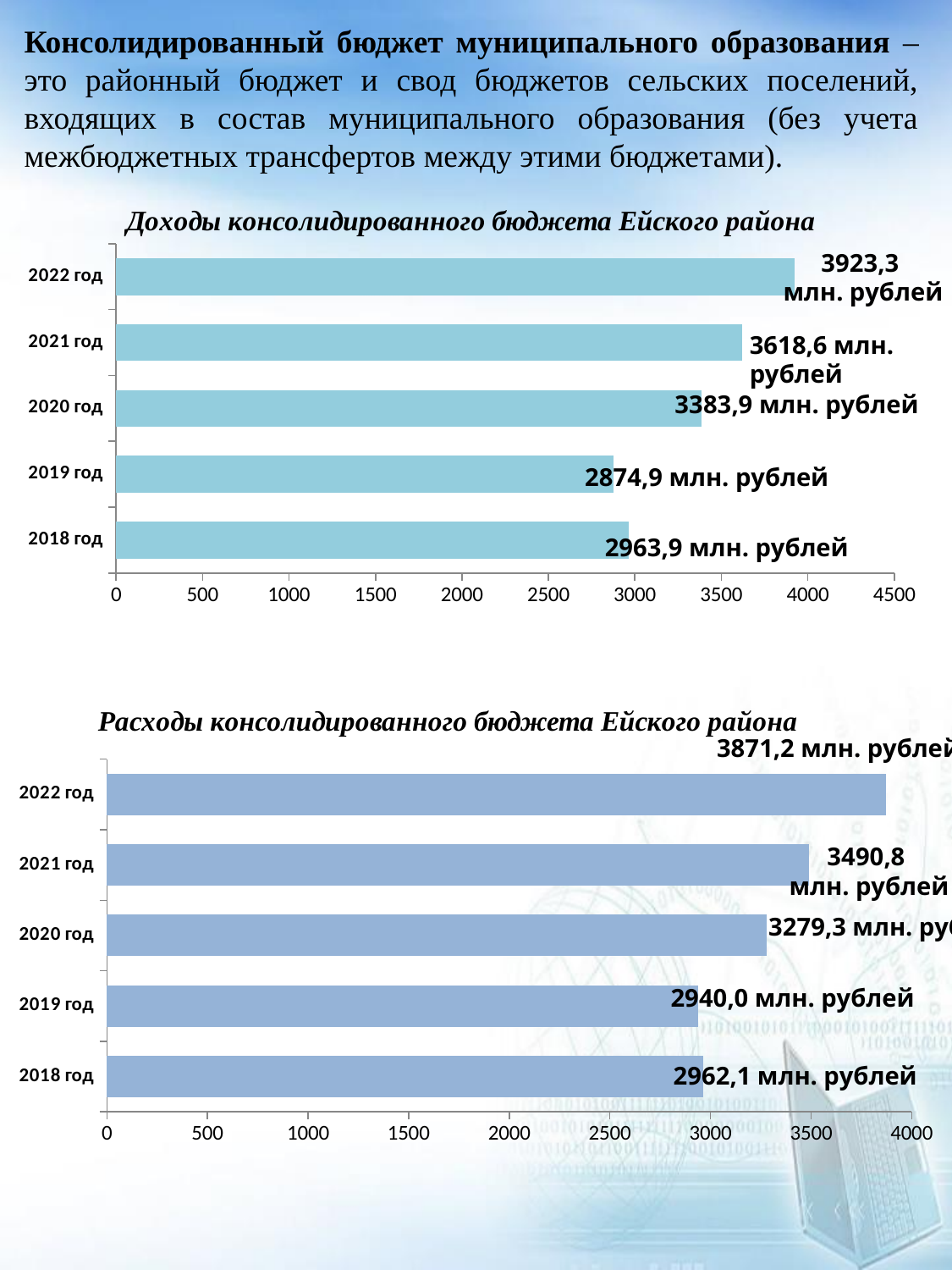
In the chart 'Доходы консолидированного бюджета Ейского района', what is the difference between 2022 год and 2021 год? 304,7 млн. рублей In the chart 'Доходы консолидированного бюджета Ейского района', what is the value for 2022 год? 3923,3 млн. рублей In the chart 'Расходы консолидированного бюджета Ейского района', what is the value for 2021 год? 3490,8 млн. рублей In the chart 'Доходы консолидированного бюджета Ейского района', how many years are shown? 5 In the chart 'Доходы консолидированного бюджета Ейского района', which year has the lowest value? 2019 год In the chart 'Расходы консолидированного бюджета Ейского района', what is the value for 2018 год? 2962,1 млн. рублей In the chart 'Доходы консолидированного бюджета Ейского района', what is the value for 2019 год? 2874,9 млн. рублей What type of chart is 'Расходы консолидированного бюджета Ейского района'? Bar chart In the chart 'Расходы консолидированного бюджета Ейского района', which year has the highest value? 2022 год In the chart 'Расходы консолидированного бюджета Ейского района', which is larger: 2019 год or 2018 год? 2018 год In the chart 'Расходы консолидированного бюджета Ейского района', what is the difference between 2022 год and 2021 год? 380,4 млн. рублей In the chart 'Доходы консолидированного бюджета Ейского района', is the value for 2020 год greater or less than 3500? less